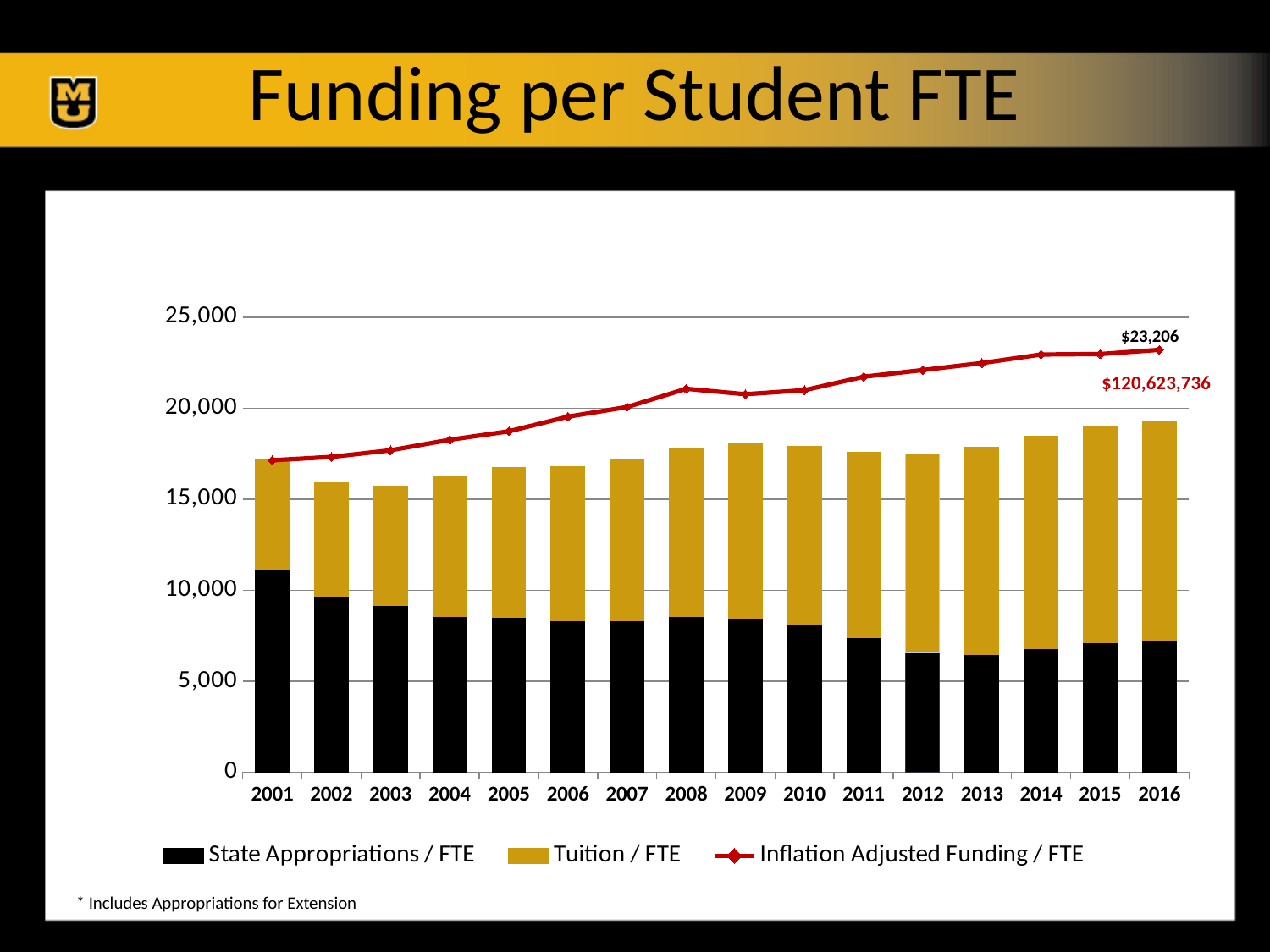
How many years are shown on the x axis of the chart? 16 What is the labelled value of Inflation Adjusted Funding / FTE in 2016? $23,206 Which year has the highest State Appropriations / FTE? 2001 What kind of chart is shown on the slide? combination bar and line chart What is the title of the slide? Funding per Student FTE How many series does the legend list? 3 Is the State Appropriations / FTE value for 2001 greater or less than 10,000? greater Does the Inflation Adjusted Funding / FTE line generally rise or fall from 2001 to 2016? rise Is the State Appropriations / FTE value for 2016 greater or less than 10,000? less Is the Inflation Adjusted Funding / FTE value for 2008 greater or less than 20,000? greater Which is larger, State Appropriations / FTE in 2001 or in 2016? 2001